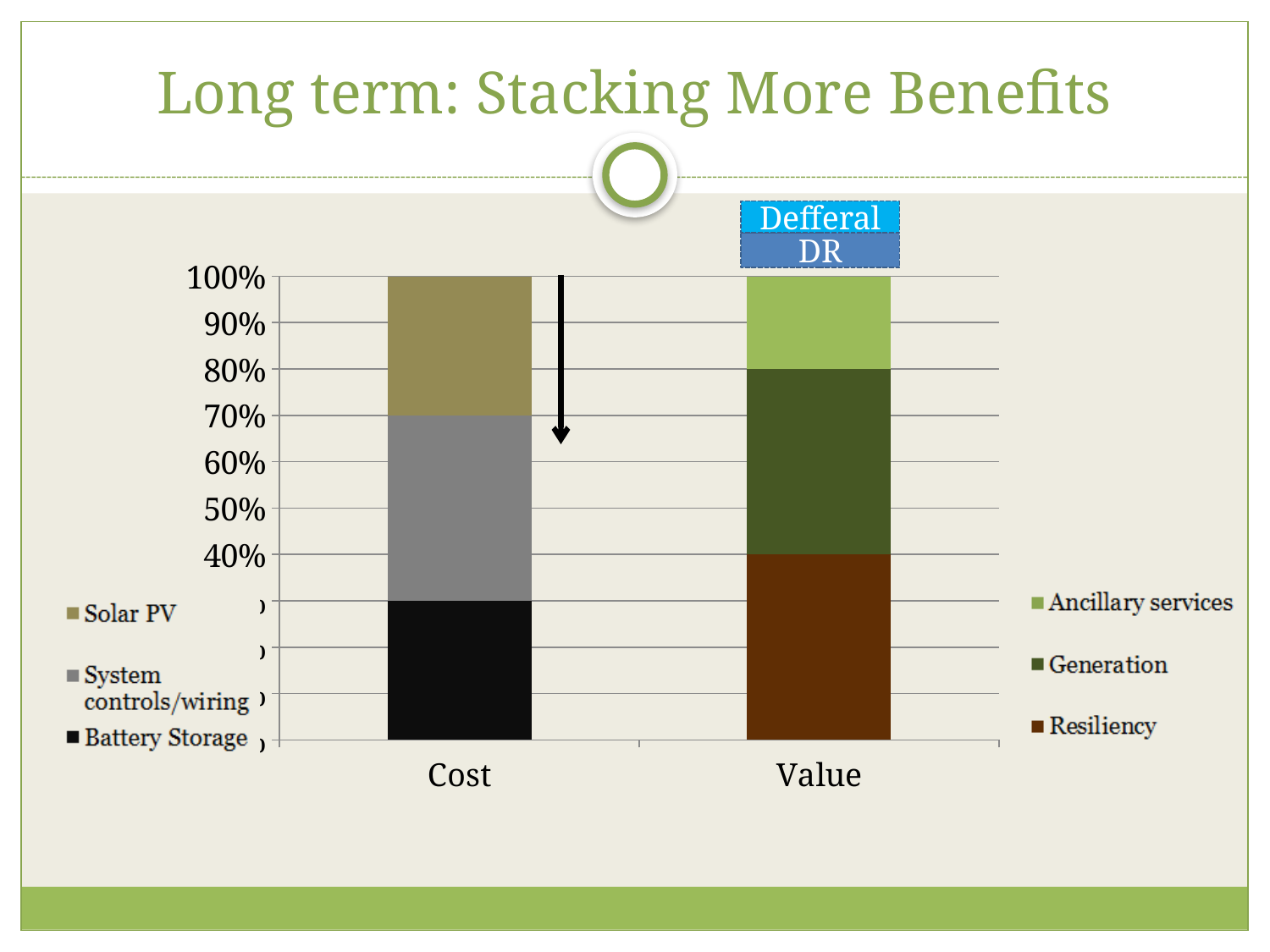
What kind of chart is shown on the slide? Stacked bar chart How many bars (categories) are plotted on the x axis? 2 Is the top of the Resiliency segment in the Value bar greater or less than 50%? less At what percentage does the Solar PV segment begin in the Cost bar? 70% Is the boundary between Battery Storage and System controls/wiring in the Cost bar greater or less than 40%? less Which is larger in the Cost bar, the Solar PV segment or the System controls/wiring segment? System controls/wiring At what percentage does the Generation segment end in the Value bar? 80% How many legend entries are shown in total across both legends? 6 Which segment of the Value bar is the smallest? Ancillary services Which segment is at the bottom of the Value bar? Resiliency How many legend entries are shown for the Cost bar? 3 At what percentage does the Resiliency segment end in the Value bar? 40%